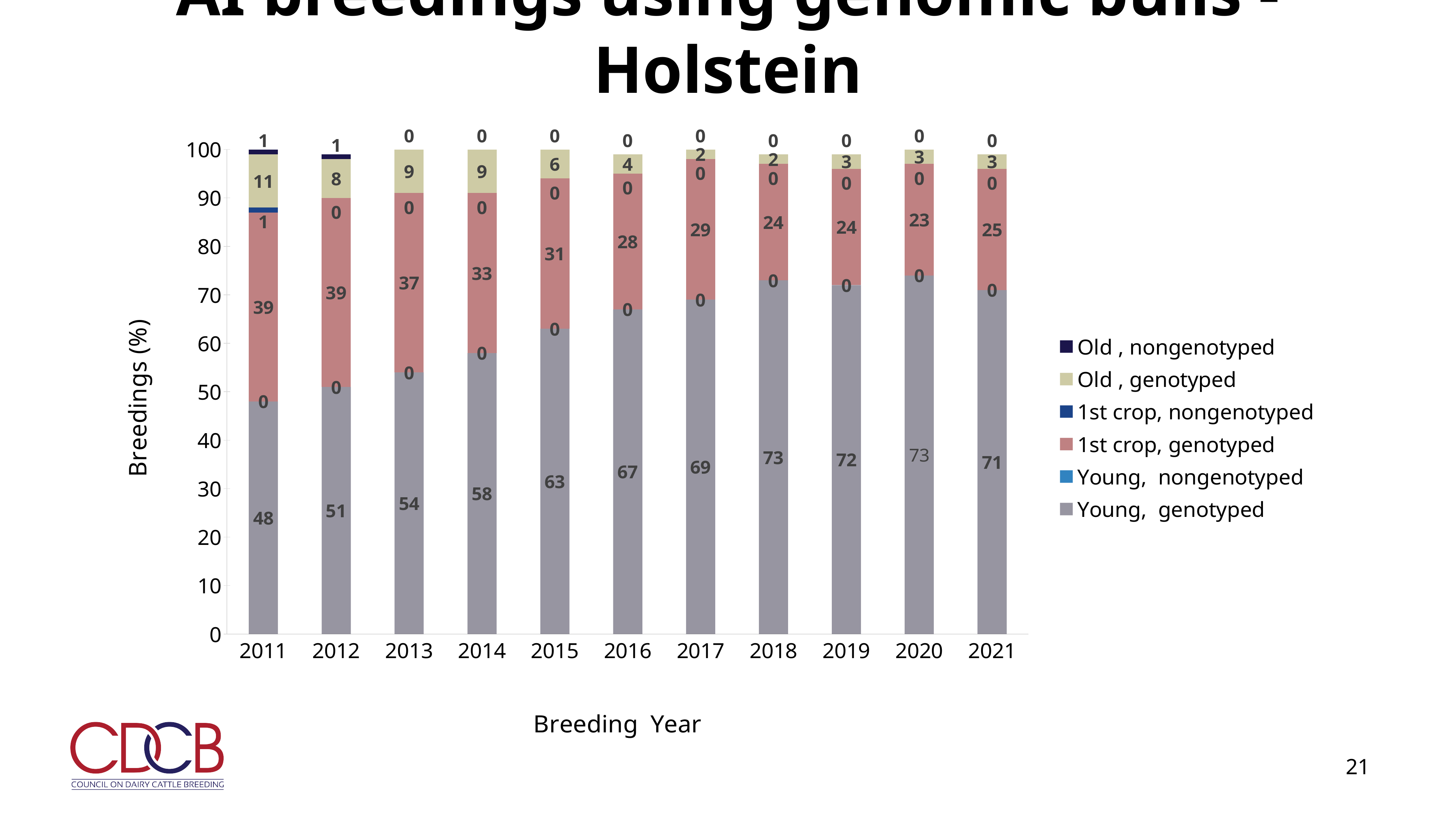
What is the value for Young, genotyped in 2021? 71 Does the Young, genotyped value rise or fall from 2011 to 2018? rise What is the value for Old, genotyped in 2012? 8 Which year has the lowest value for Young, genotyped? 2011 What kind of chart is shown on the slide? stacked bar chart What is the difference between the Young, genotyped values for 2018 and 2011? 25 What is the value for 1st crop, genotyped in 2015? 31 How many series does the legend list? 6 How many breeding years are shown on the x axis? 11 Which is larger, the 1st crop, genotyped value in 2013 or in 2020? 2013 Which year has the highest value for Old, genotyped? 2011 What is the value for Young, genotyped in 2011? 48